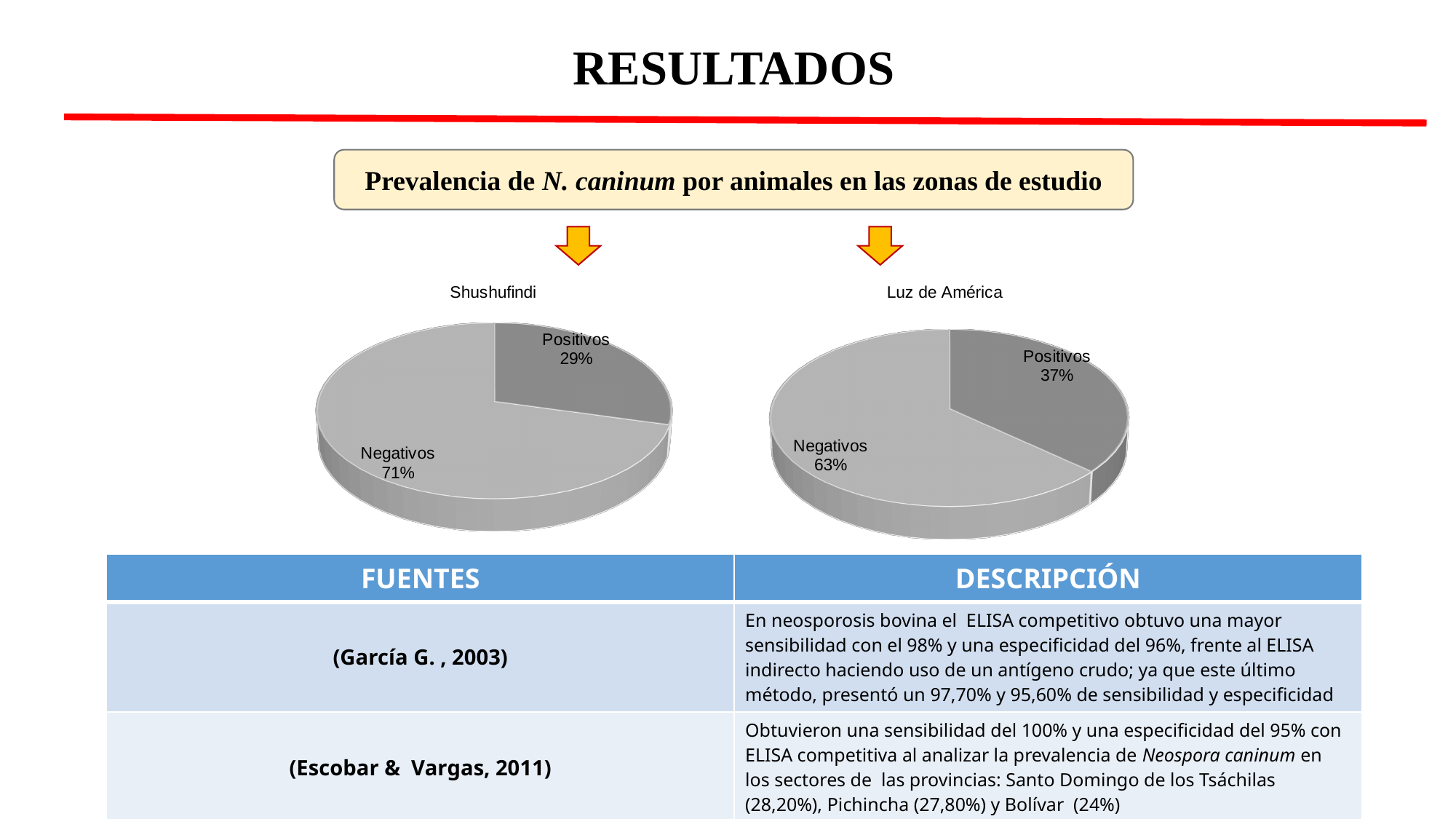
How many slices does the Luz de América chart have? 2 Which has a larger Positivos share, the Shushufindi chart or the Luz de América chart? Luz de América In the Shushufindi chart, what percentage is Positivos? 29% In the Luz de América chart, what percentage is Negativos? 63% What kind of chart is the Shushufindi chart? Pie chart In the Luz de América chart, what is the difference between Negativos and Positivos? 26% In the Shushufindi chart, what is the difference between Negativos and Positivos? 42% In the Shushufindi chart, which slice is the largest? Negativos In the Shushufindi chart, what percentage is Negativos? 71% How many pie charts are shown on the slide? 2 In the Luz de América chart, what percentage is Positivos? 37% In the Luz de América chart, which slice is the smallest? Positivos